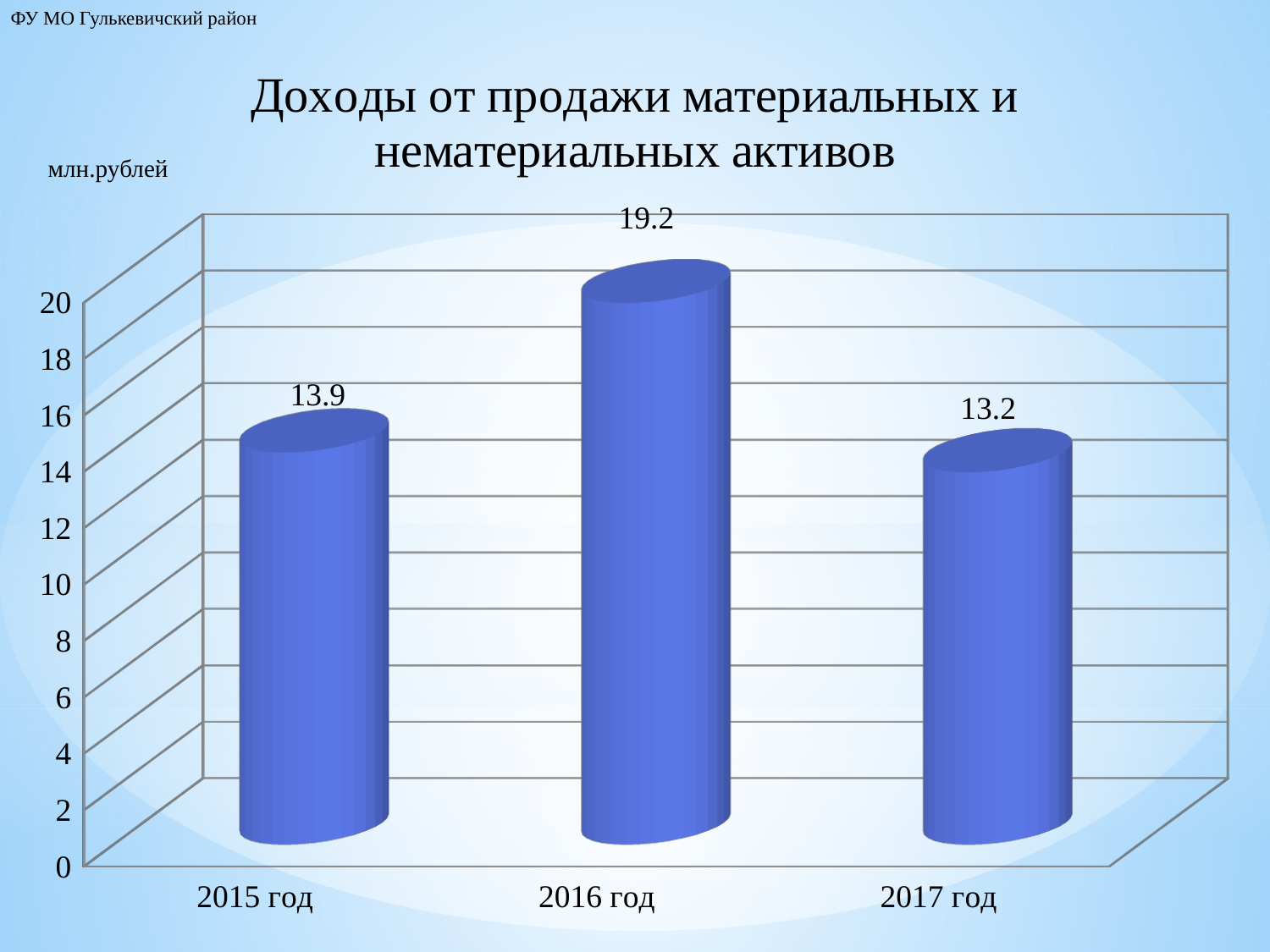
What is the difference between the values for 2015 год and 2017 год? 0.7 How many years are shown on the chart? 3 What is the value for 2017 год? 13.2 Which is larger, the value for 2015 год or the value for 2017 год? 2015 год What unit is indicated for the values on the chart? млн.рублей Which year has the lowest value? 2017 год Is the value for 2016 год greater or less than 18? greater What kind of chart is shown on the slide? bar chart What is the difference between the values for 2016 год and 2015 год? 5.3 Which year has the highest value? 2016 год What is the value for 2016 год? 19.2 What is the value for 2015 год? 13.9